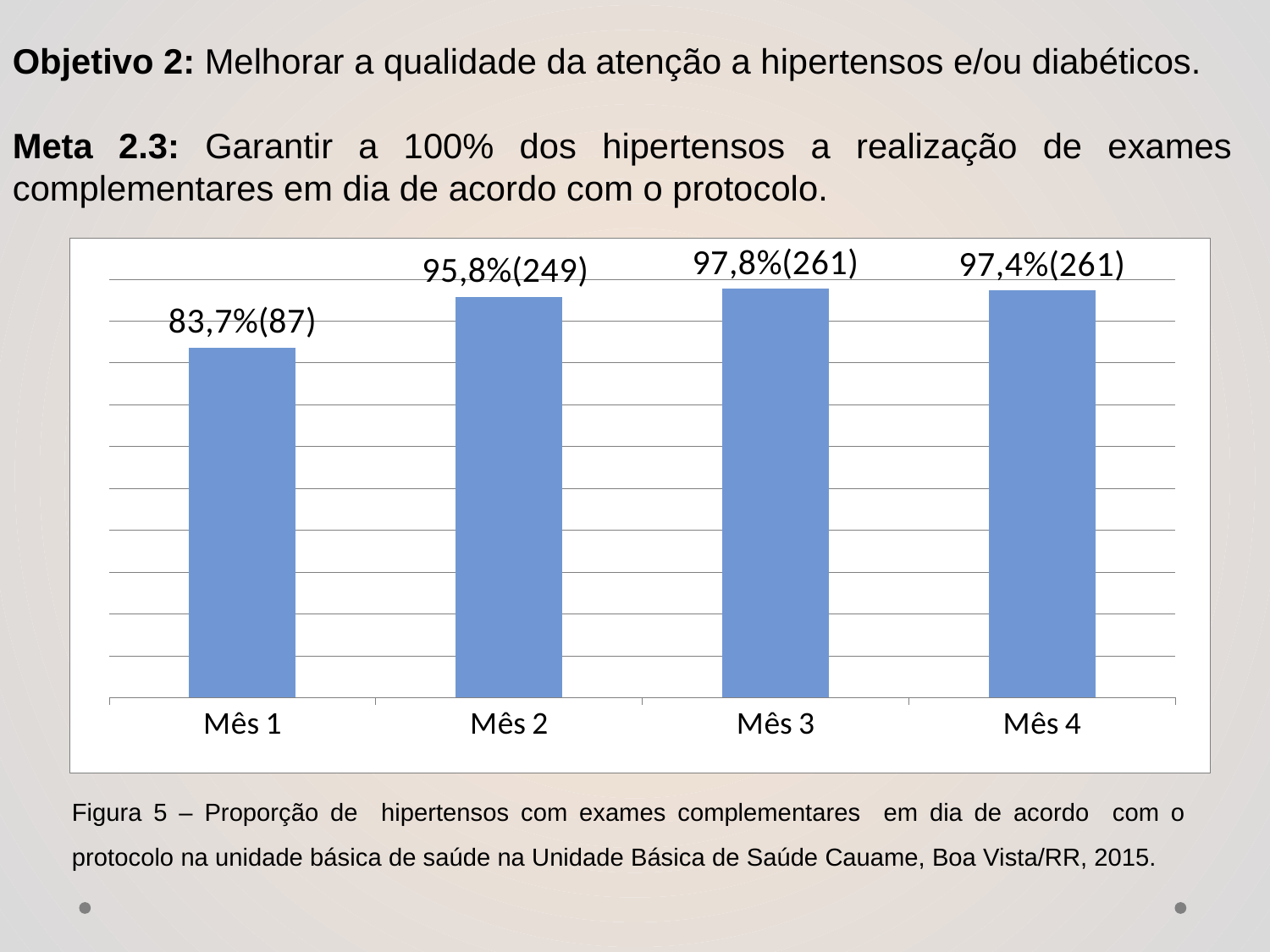
How many hypertensive patients are shown in parentheses for Mês 2? 249 Which has a higher percentage, Mês 3 or Mês 4? Mês 3 What percentage is shown for Mês 4? 97,4% Which month has the lowest percentage? Mês 1 Which month has the highest percentage? Mês 3 What is the difference between the counts in parentheses for Mês 2 and Mês 1? 162 What is the data label shown for Mês 1? 83,7%(87) How many months (categories) are shown on the x axis? 4 What is the data label shown for Mês 3? 97,8%(261) What percentage is shown for Mês 2? 95,8% What is the difference in percentage points between Mês 2 and Mês 1? 12,1 What kind of chart is shown on the slide? Bar chart